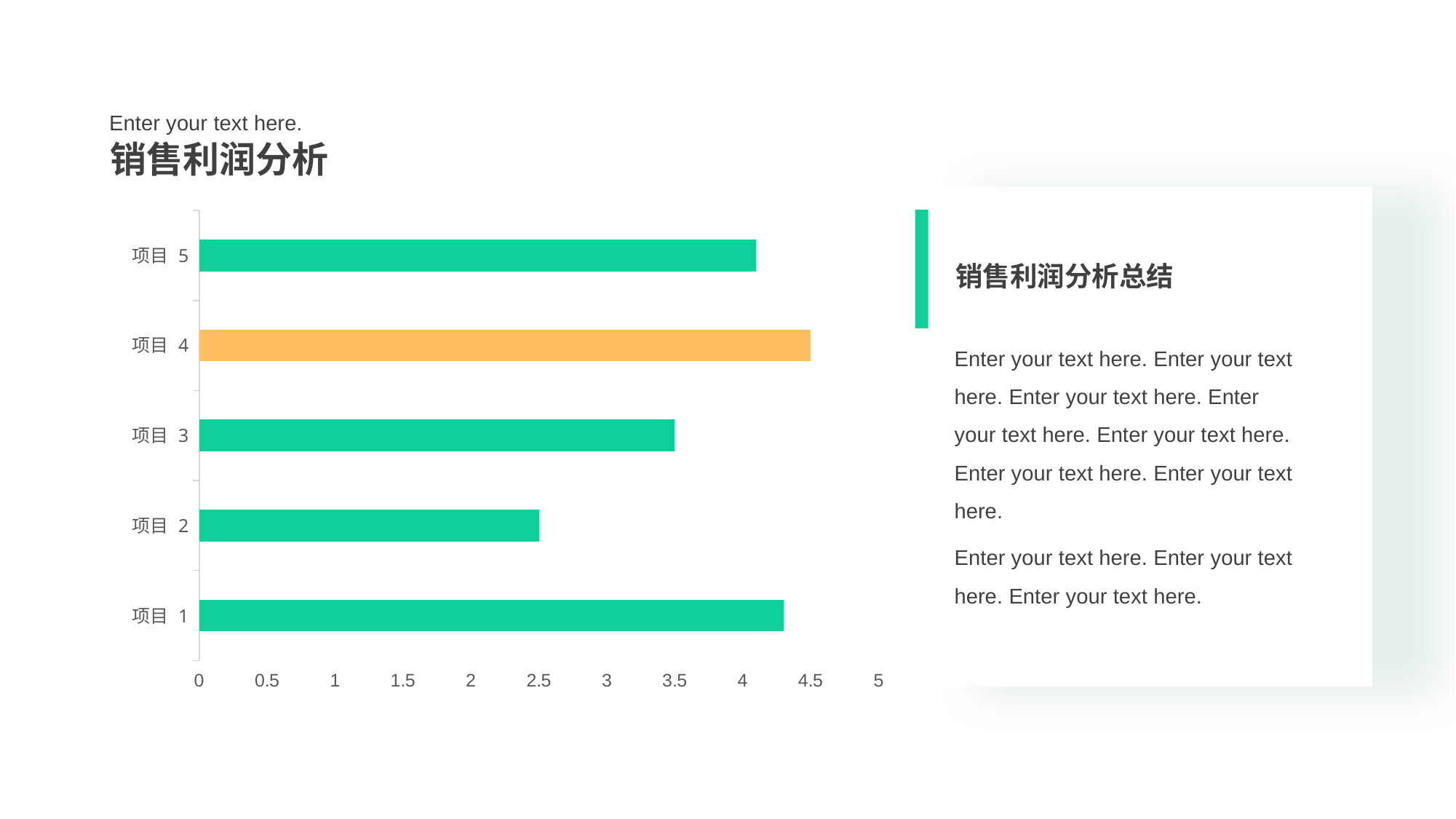
What is the difference between the values for 项目 4 and 项目 2? 2 Is the value for 项目 1 greater or less than 4? greater Which category has the lowest value? 项目 2 Which category has the highest value? 项目 4 Which is larger, the value for 项目 1 or the value for 项目 3? 项目 1 What is the value for 项目 2? 2.5 What type of chart is shown on the slide? bar chart How many categories are plotted in the chart? 5 What is the value for 项目 3? 3.5 What is the value for 项目 4? 4.5 Which bar is coloured differently (orange) from the others? 项目 4 Is the value for 项目 5 greater or less than 4.5? less